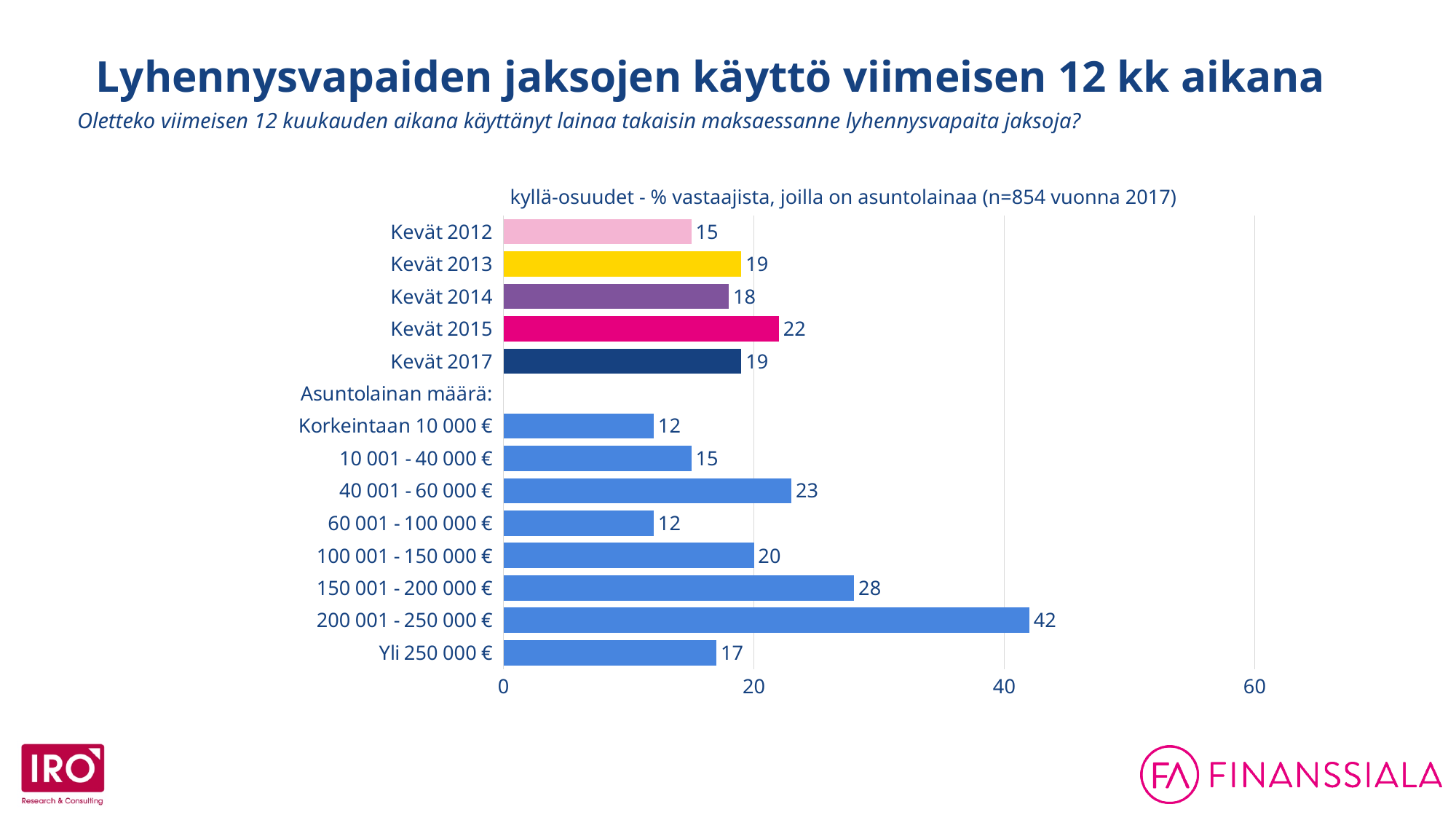
Among the Kevät (spring) survey years, which has the lowest value? Kevät 2012 What is the value for Kevät 2015? 22 Which is larger, the value for Kevät 2013 or the value for Kevät 2014? Kevät 2013 What is the difference between the values for 200 001 - 250 000 € and 150 001 - 200 000 €? 14 Is the value for 40 001 - 60 000 € greater or less than 20? greater What is the value for Yli 250 000 €? 17 What kind of chart is shown on the slide? Bar chart Which category has the highest value in the chart? 200 001 - 250 000 € What is the difference between the values for Kevät 2015 and Kevät 2012? 7 What is the value for the 200 001 - 250 000 € loan category? 42 How many loan amount (Asuntolainan määrä) categories are plotted? 8 What is the chart's subtitle above the bars? kyllä-osuudet - % vastaajista, joilla on asuntolainaa (n=854 vuonna 2017)